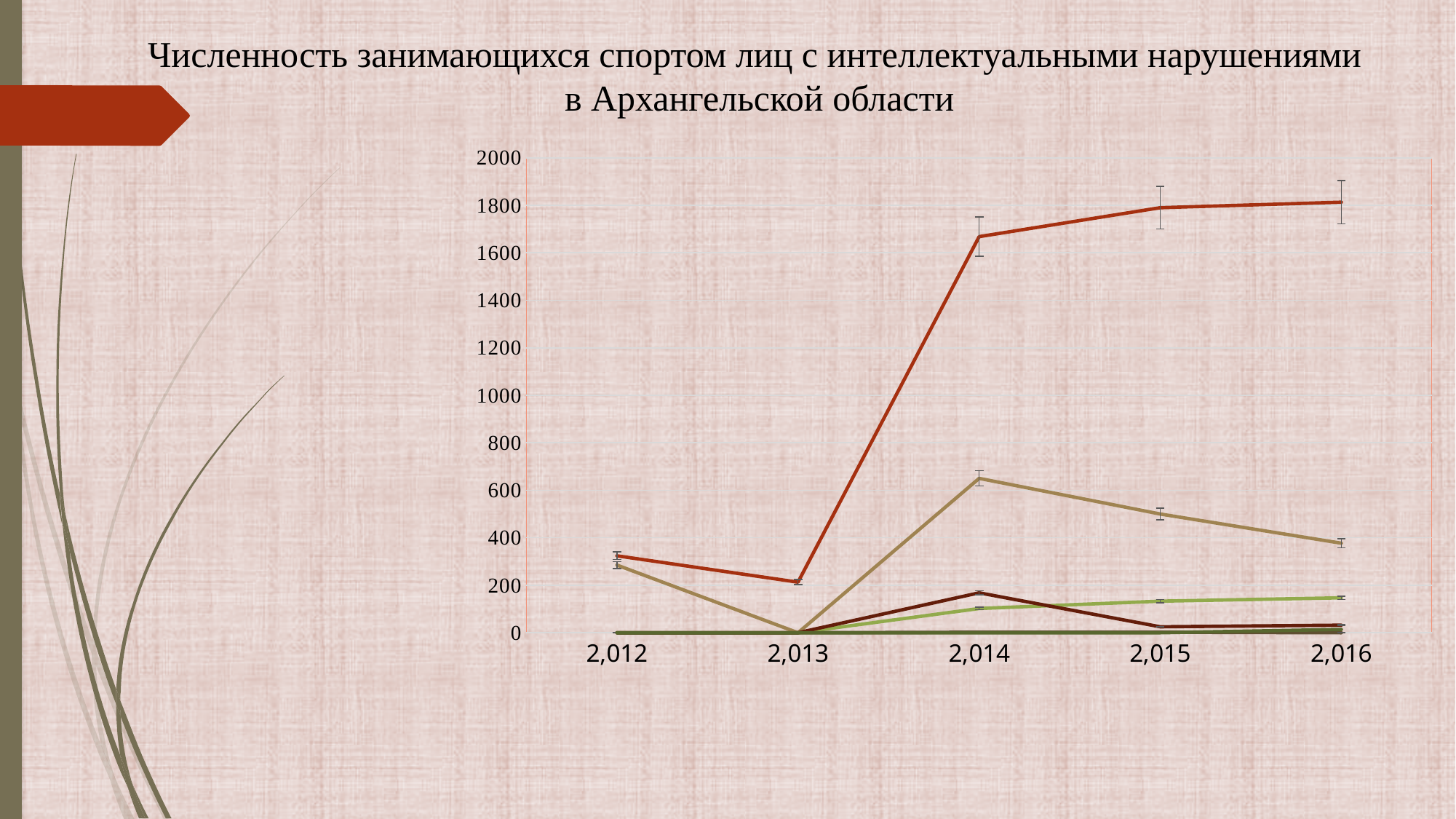
Is the value of the tan line at 2,016 greater or less than 600? less Is the value of the red line at 2,013 greater or less than 400? less Is the value of the red line at 2,014 greater or less than 1400? greater At 2,016, which line has the larger value, the red line or the tan line? the red line Does the tan line rise or fall from 2,014 to 2,016? fall In which year does the tan line reach its highest value? 2,014 What kind of chart is shown on the slide? line chart In which year does the red line reach its lowest value? 2,013 How many years are shown along the x axis of the chart? 5 What is the highest tick value shown on the y axis of the chart? 2000